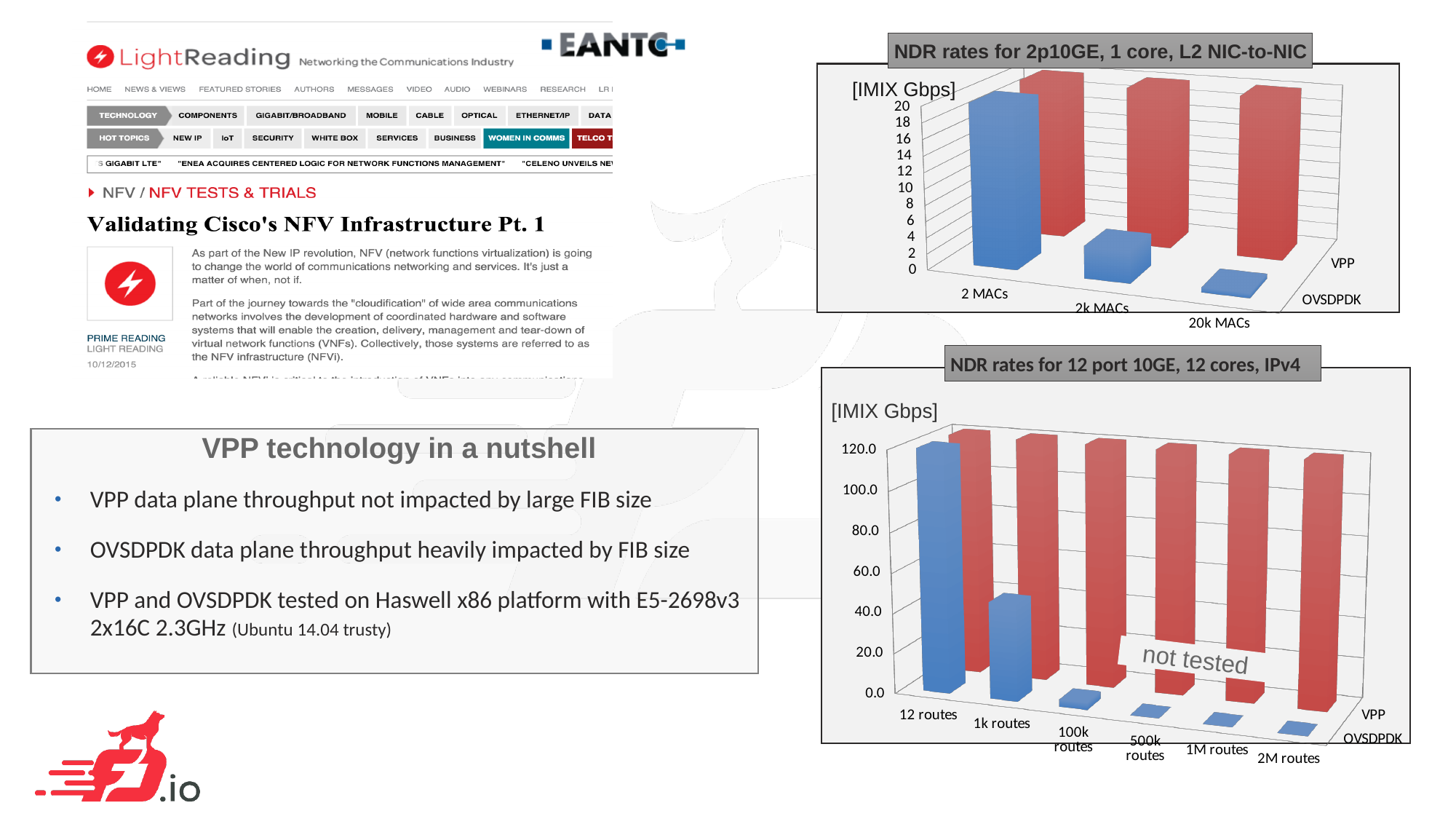
How many categories are shown on the x axis of the 'NDR rates for 12 port 10GE, 12 cores, IPv4' chart? 6 How many categories are shown on the x axis of the 'NDR rates for 2p10GE, 1 core, L2 NIC-to-NIC' chart? 3 What kind of chart is the 'NDR rates for 2p10GE, 1 core, L2 NIC-to-NIC' chart? Bar chart What text is written across the bars of the 'NDR rates for 12 port 10GE, 12 cores, IPv4' chart? not tested In the 'NDR rates for 2p10GE, 1 core, L2 NIC-to-NIC' chart, is the OVSDPDK value for 2k MACs greater or less than 10? less In the 'NDR rates for 12 port 10GE, 12 cores, IPv4' chart, is the OVSDPDK value for 1k routes greater or less than 60.0? less In the 'NDR rates for 12 port 10GE, 12 cores, IPv4' chart, is the VPP value for 2M routes greater or less than 100.0? greater In the 'NDR rates for 12 port 10GE, 12 cores, IPv4' chart, which is larger for 100k routes: VPP or OVSDPDK? VPP In the 'NDR rates for 2p10GE, 1 core, L2 NIC-to-NIC' chart, which category has the lowest OVSDPDK value? 20k MACs How many series does the 'NDR rates for 2p10GE, 1 core, L2 NIC-to-NIC' chart show? 2 In the 'NDR rates for 2p10GE, 1 core, L2 NIC-to-NIC' chart, do the OVSDPDK values rise or fall from 2 MACs to 20k MACs? Fall What unit is shown on the y axis of the 'NDR rates for 2p10GE, 1 core, L2 NIC-to-NIC' chart? [IMIX Gbps]